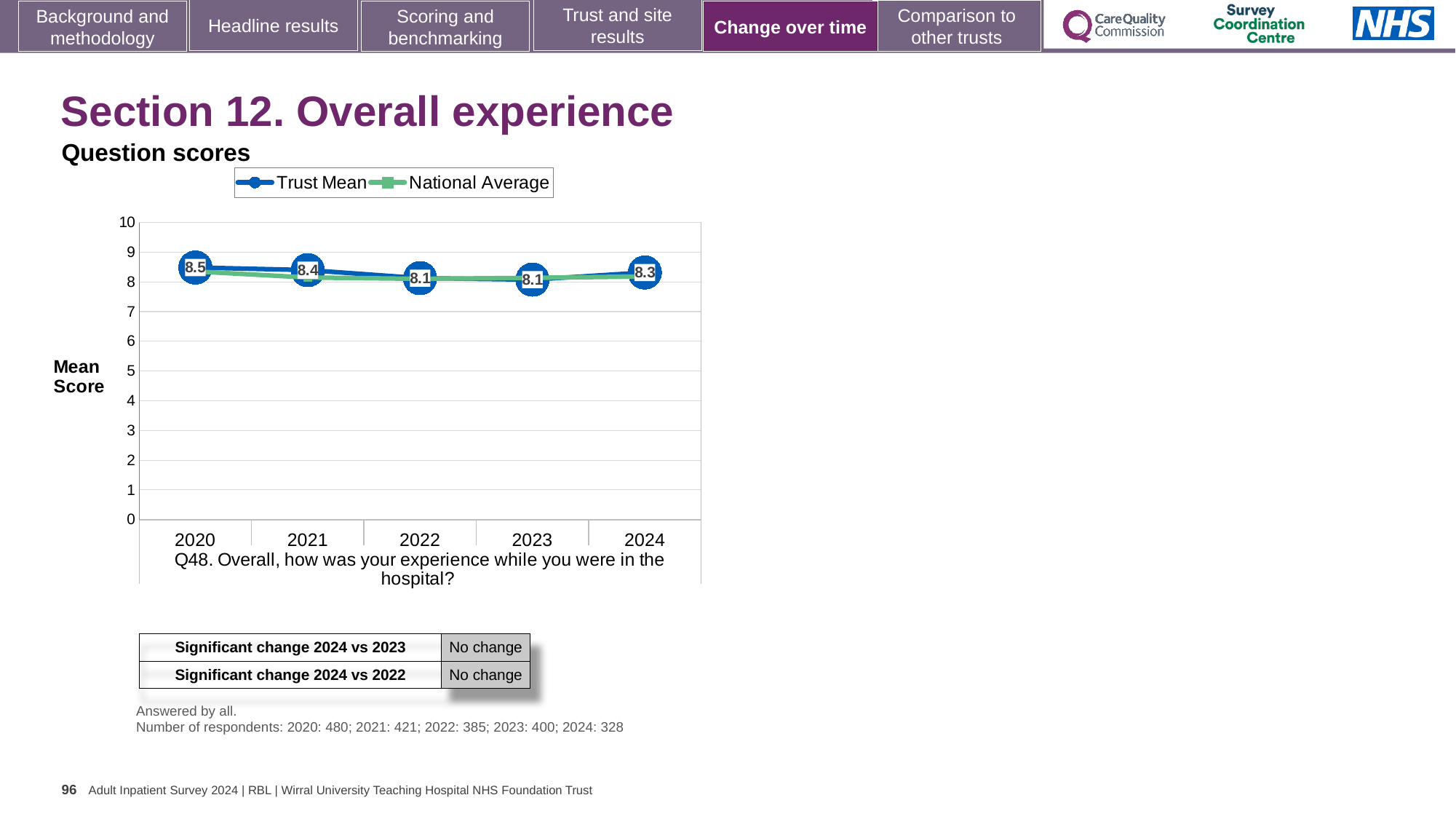
What is the difference between the Trust Mean score in 2020 and in 2024? 0.2 Is the National Average value for 2022 greater or less than 7? greater What is the Trust Mean score for 2020? 8.5 In which year is the Trust Mean score highest? 2020 How many years are plotted on the x axis? 5 What is the Trust Mean score for 2024? 8.3 Does the Trust Mean score rise or fall from 2020 to 2022? Fall What is the lowest Trust Mean score shown on the chart? 8.1 How many series does the legend list? 2 What is the Trust Mean score for 2022? 8.1 Which year has the larger Trust Mean score, 2021 or 2023? 2021 What kind of chart is shown on the slide? Line chart